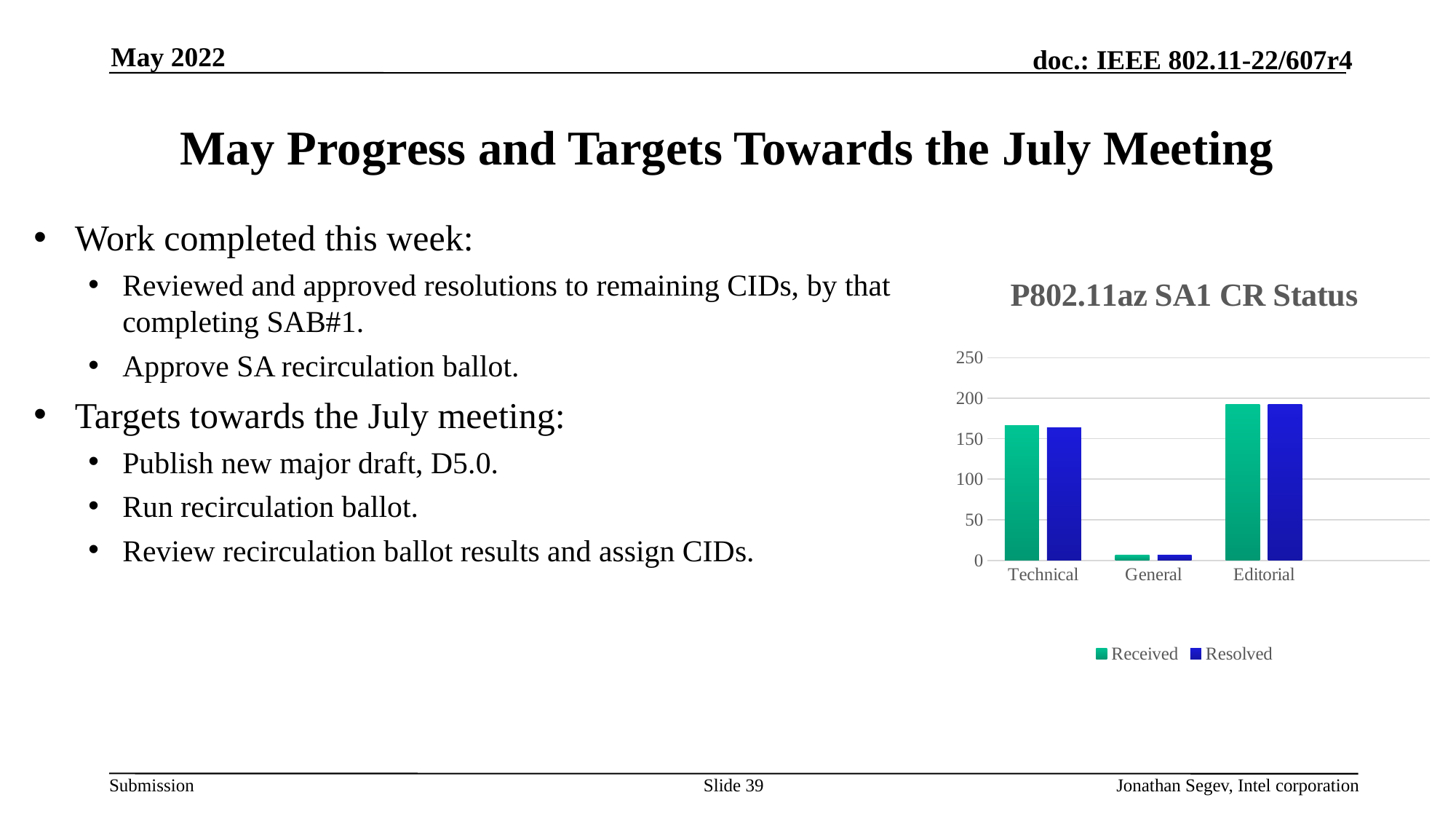
Which is larger, the Received value for Technical or the Received value for Editorial? Editorial Which category has the highest Received value? Editorial What is the title of the chart on the slide? P802.11az SA1 CR Status Is the Received value for General greater or less than 50? less Which category has the lowest Resolved value? General What kind of chart is shown on the slide? bar chart How many categories are shown on the x axis of the chart? 3 Which series is shown in blue in the chart's legend? Resolved Is the Received value for Technical greater or less than 150? greater Is the Received value for Editorial greater or less than 200? less How many series does the chart's legend list? 2